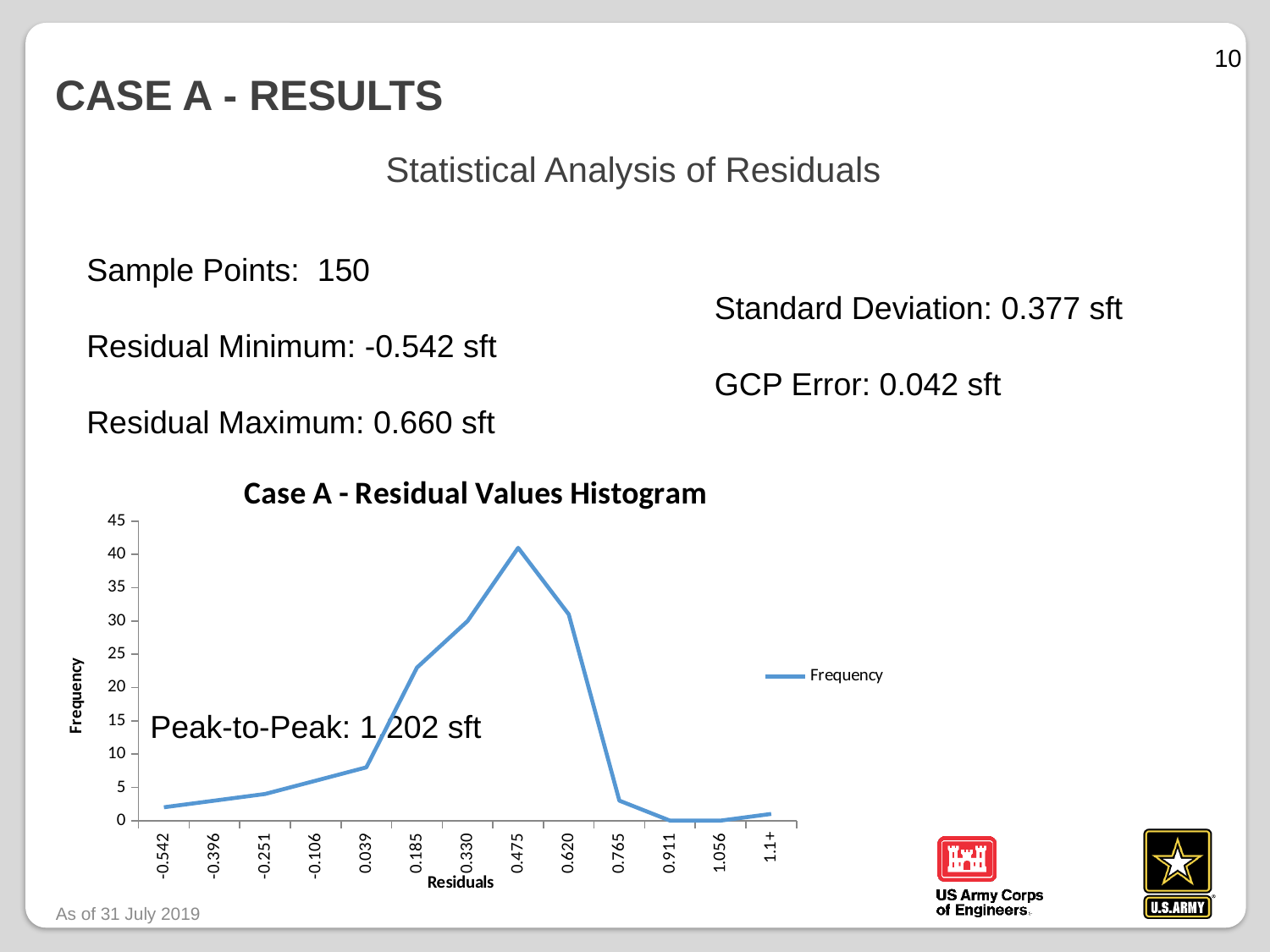
What is the label of the y axis of the chart? Frequency Is the frequency at 0.475 greater or less than 40? greater Is the frequency at 0.765 greater or less than 5? less Is the frequency at 0.330 greater or less than 25? greater How many categories are shown along the x axis of the chart? 13 How many series does the legend list? 1 Which has the higher frequency, 0.185 or 0.765? 0.185 At which residual value does the frequency reach its highest point? 0.475 Does the frequency rise or fall between 0.475 and 0.765 along the x axis? fall What is the title of the chart? Case A - Residual Values Histogram What kind of chart is shown on the slide? line chart